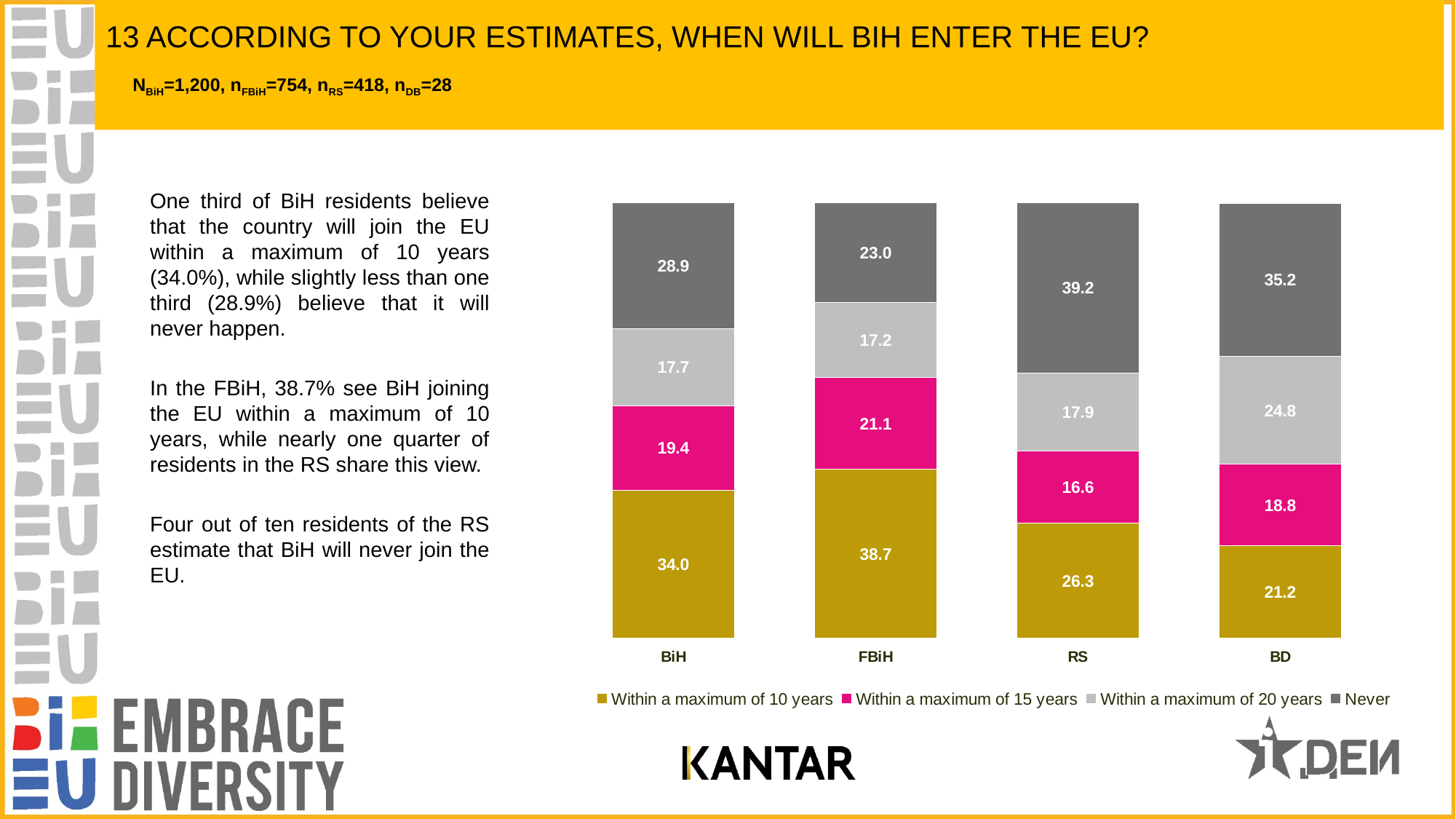
What is the value for "Within a maximum of 15 years" for BiH? 19.4 What kind of chart is shown on the slide? Stacked bar chart Which category has the highest value for "Within a maximum of 10 years"? FBiH Which is larger: the "Within a maximum of 15 years" value for FBiH or for RS? FBiH Which colour represents the "Never" series in the chart? Dark grey How many series does the legend list? 4 What is the value for "Within a maximum of 20 years" for BD? 24.8 Which category has the lowest value for "Never"? FBiH What is the value for "Never" for RS? 39.2 What is the value for "Within a maximum of 10 years" for FBiH? 38.7 What is the difference between the "Never" values for RS and BiH? 10.3 How many categories are shown on the x axis? 4